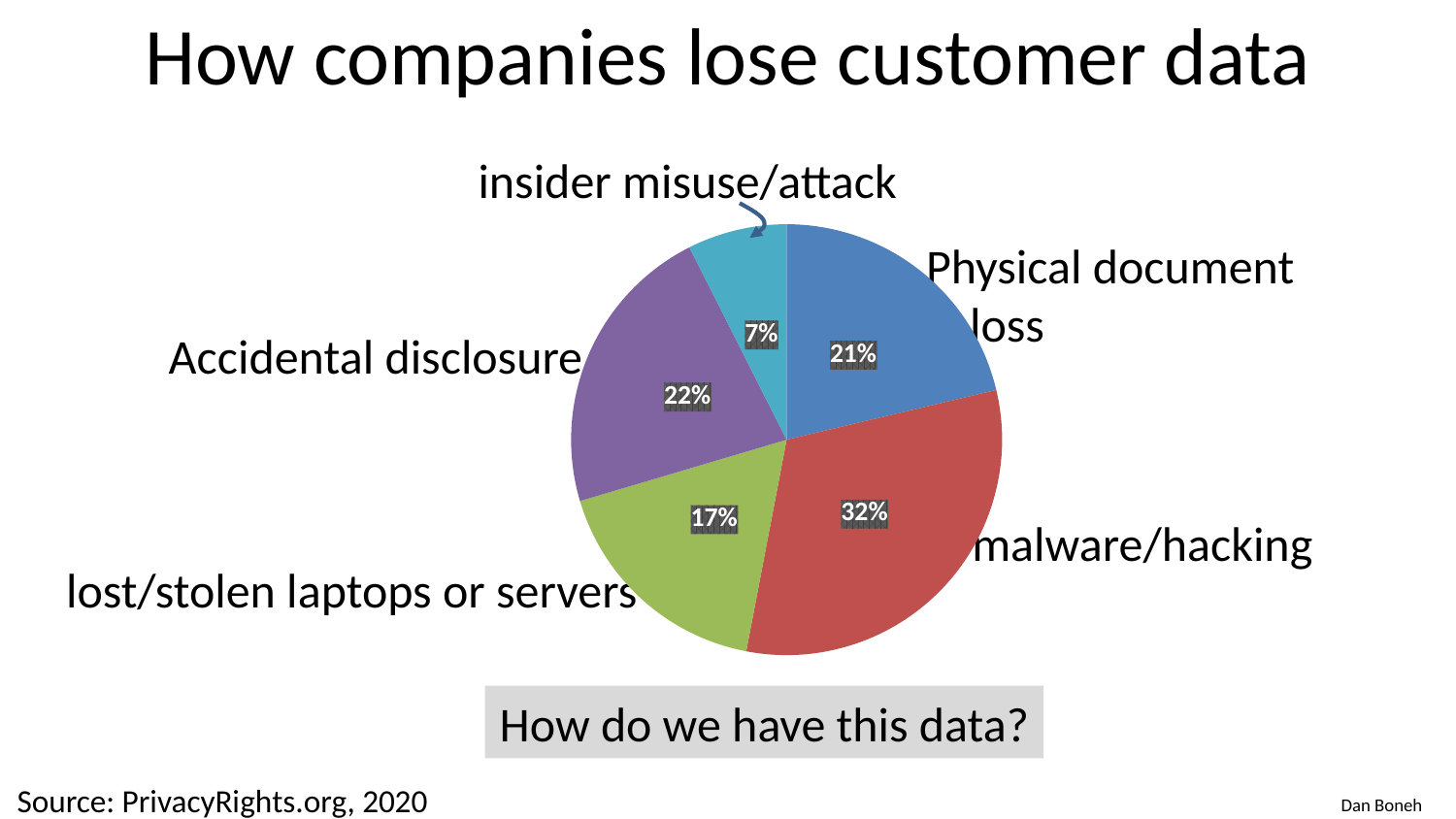
What share of the pie is malware/hacking? 32% What kind of chart is shown on the slide? pie chart What share of the pie is lost/stolen laptops or servers? 17% Which category has the largest slice of the pie? malware/hacking What is the difference in percentage points between malware/hacking and Physical document loss? 11 What share of the pie is Physical document loss? 21% What is the title of the slide containing the chart? How companies lose customer data How many slices does the pie chart have? 5 What share of the pie is Accidental disclosure? 22% Which is larger, the slice for Accidental disclosure or the slice for lost/stolen laptops or servers? Accidental disclosure Which category has the smallest slice of the pie? insider misuse/attack What share of the pie is insider misuse/attack? 7%